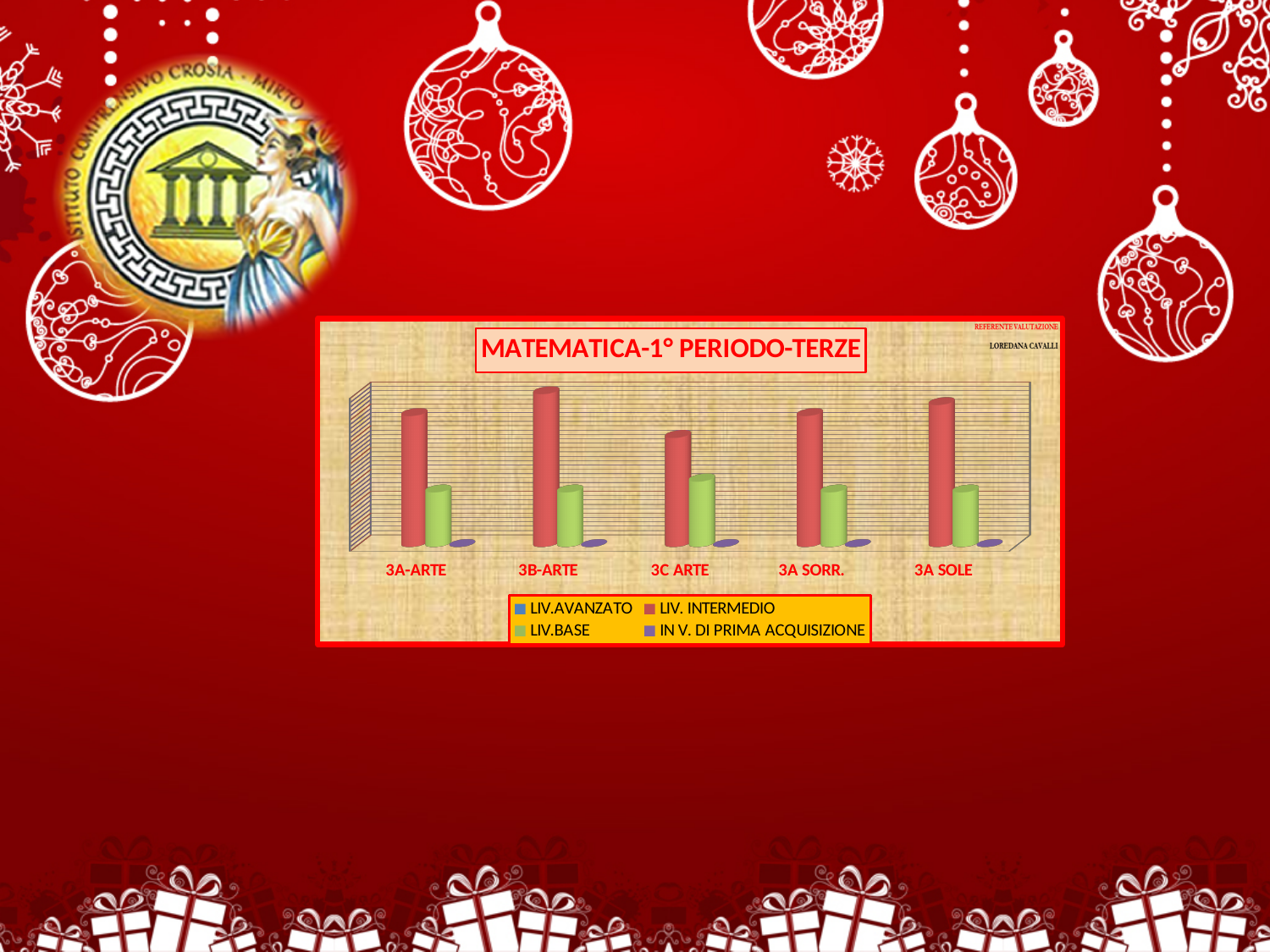
Which class has the larger LIV. INTERMEDIO bar, 3A-ARTE or 3C ARTE? 3A-ARTE What kind of chart is shown on the slide? bar chart For 3A SOLE, which is larger: LIV.BASE or IN V. DI PRIMA ACQUISIZIONE? LIV.BASE What is the title of the chart? MATEMATICA-1° PERIODO-TERZE Which class has the larger LIV. INTERMEDIO bar, 3B-ARTE or 3C ARTE? 3B-ARTE How many classes (categories) are shown on the x axis of the chart? 5 Which class has the highest LIV. INTERMEDIO bar? 3B-ARTE Which class has the lowest LIV. INTERMEDIO bar? 3C ARTE How many series does the chart legend list? 4 Which series is shown in green in the chart legend? LIV.BASE